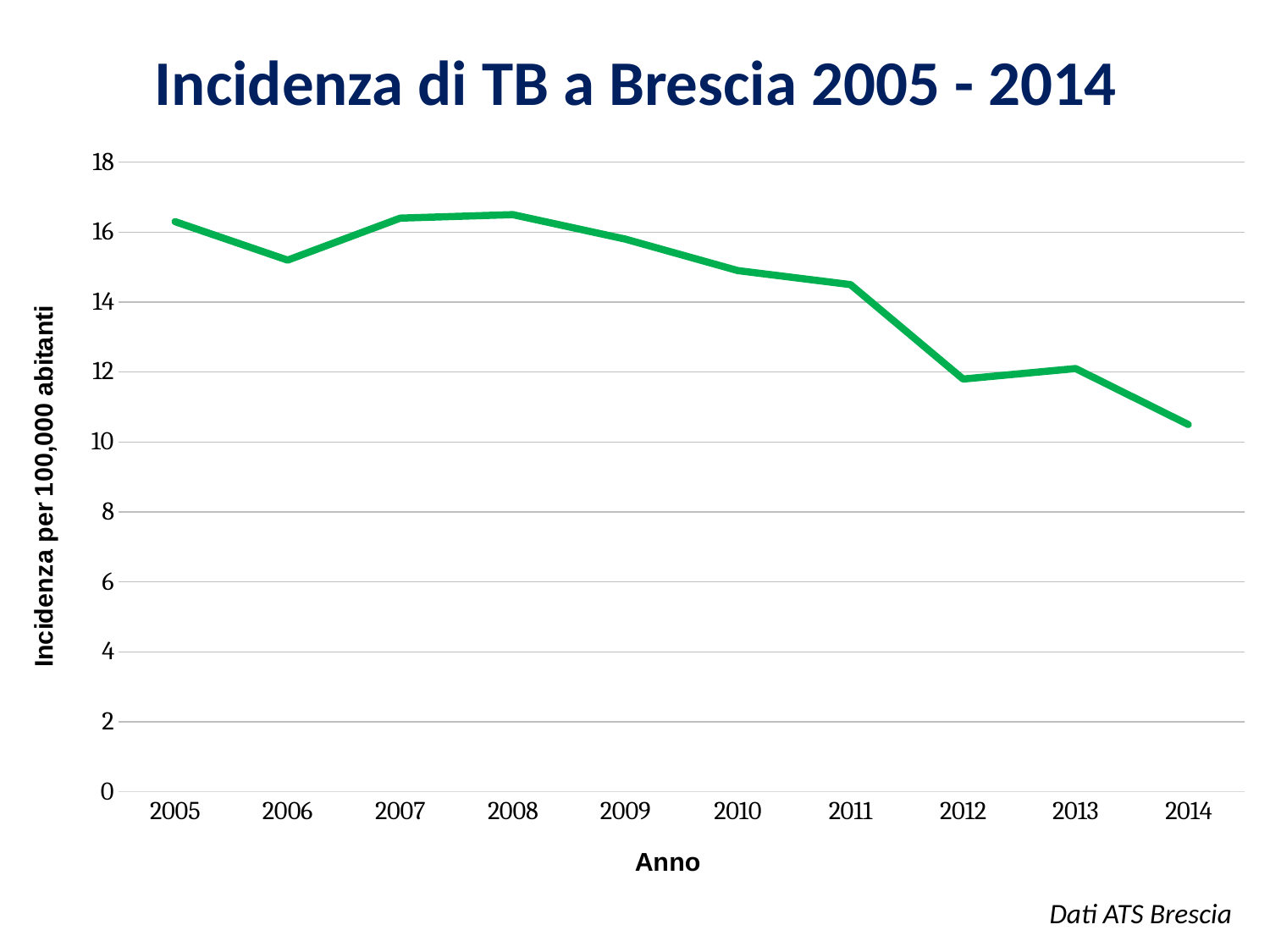
Which year has the higher incidence, 2005 or 2014? 2005 Is the value for 2011 greater or less than 14? greater Is the value for 2014 greater or less than 12? less Which year has the lowest TB incidence? 2014 What kind of chart is shown on the slide? line chart What is the label of the y axis? Incidenza per 100,000 abitanti How many years are plotted on the x axis? 10 Is the value for 2012 greater or less than 14? less What is the title of the chart? Incidenza di TB a Brescia 2005 - 2014 Which year has the higher incidence, 2009 or 2012? 2009 Overall, do the values rise or fall from 2005 to 2014? fall